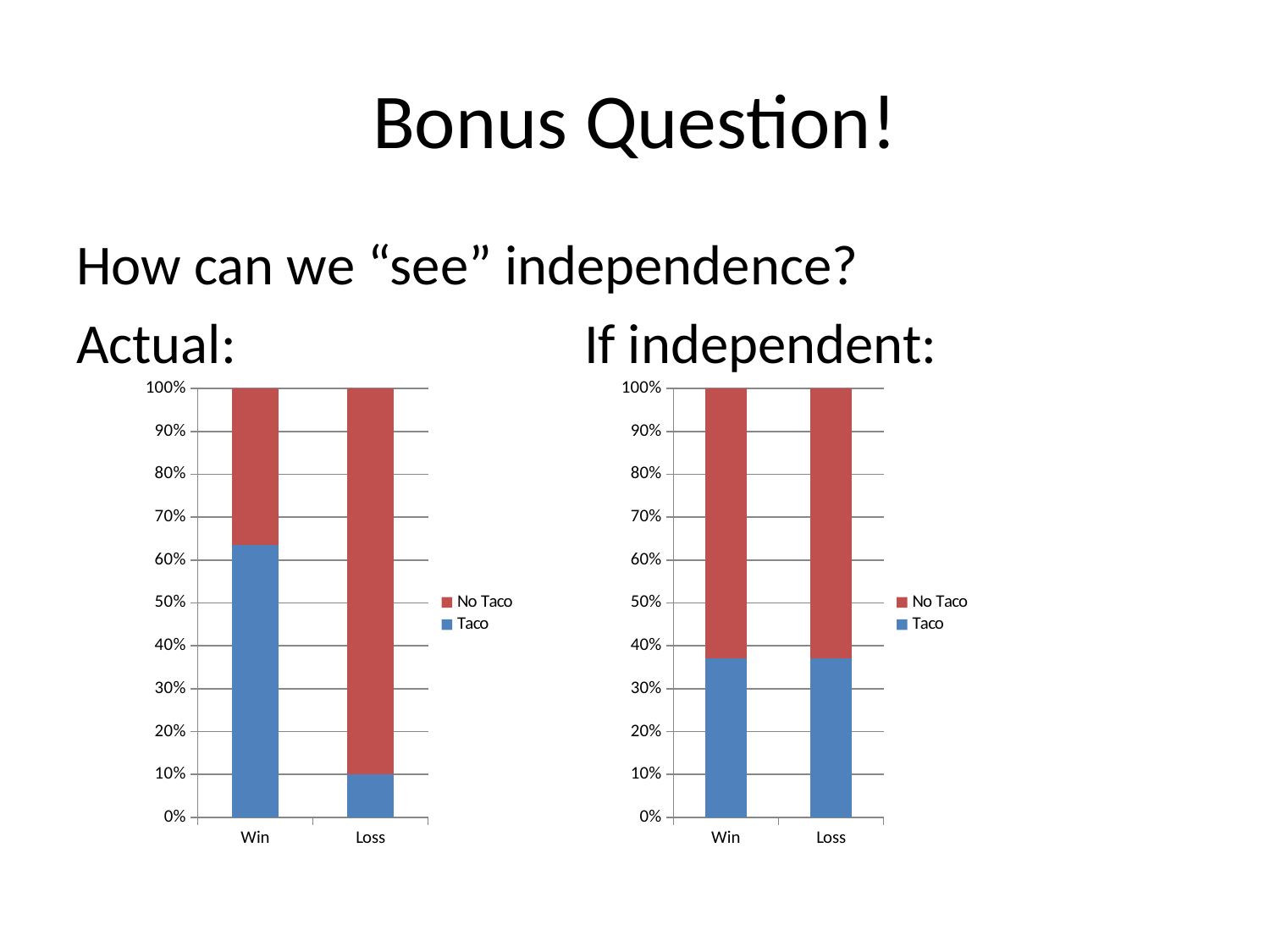
What are the two legend entries in the 'Actual' chart on the left? No Taco and Taco How many series does the legend of the 'If independent' chart on the right list? 2 In the 'If independent' chart on the right, what colour represents the Taco series? Blue In the 'Actual' chart on the left, is the Taco value for Loss greater or less than 20%? less What kind of chart is the 'Actual' chart on the left? Stacked bar chart How many categories are shown on the x axis of the 'Actual' chart on the left? 2 In the 'If independent' chart on the right, is the Taco value for Win greater or less than 50%? less In the 'If independent' chart on the right, is the Taco value for Loss greater or less than 30%? greater In the 'Actual' chart on the left, which category has the larger No Taco share, Win or Loss? Loss In the 'If independent' chart on the right, what is the total height of the stacked bar for Win? 100% In the 'Actual' chart on the left, which category has the larger Taco share, Win or Loss? Win